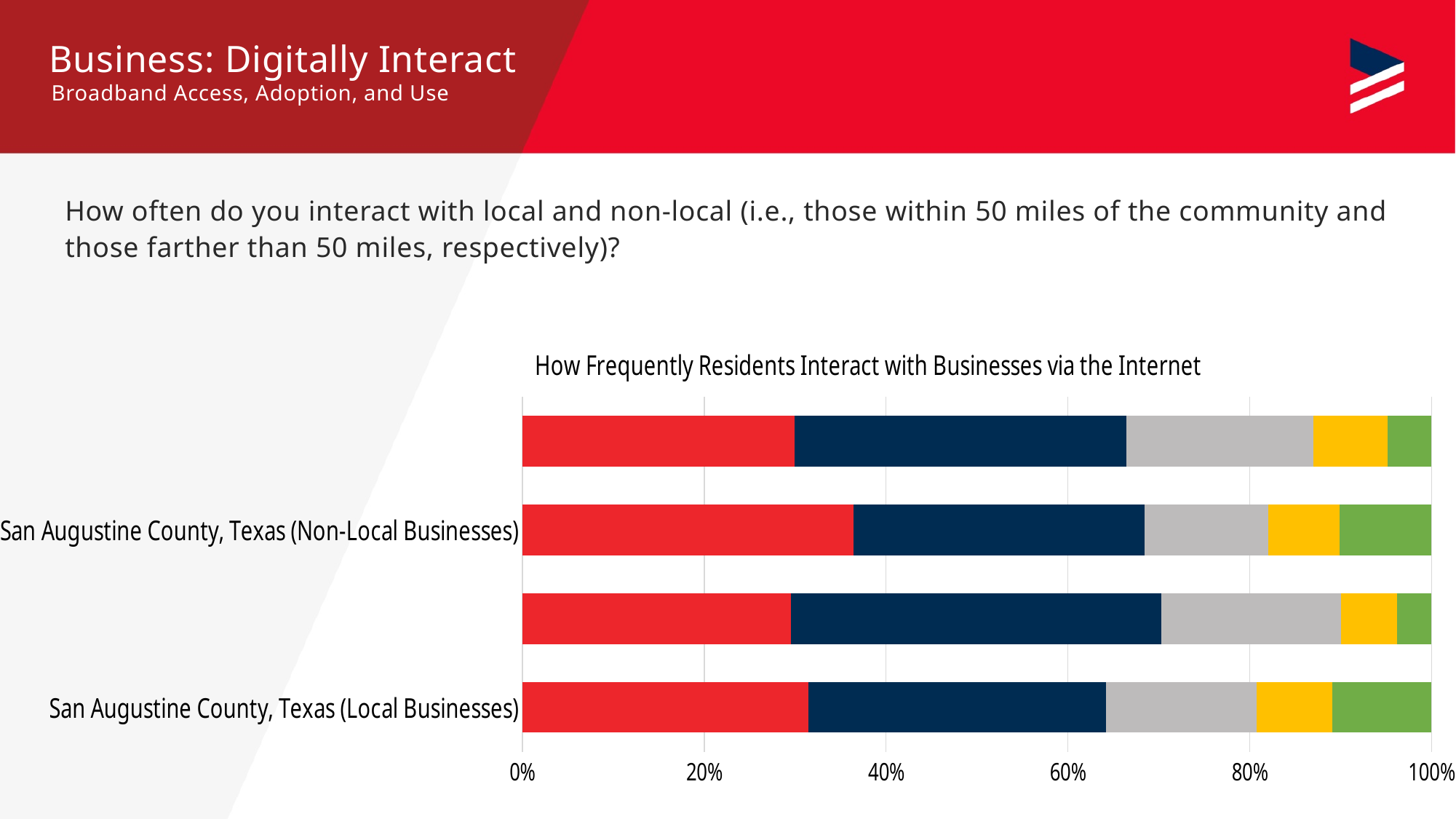
Which has the larger red (first) segment: the bar for San Augustine County, Texas (Non-Local Businesses) or the bar for San Augustine County, Texas (Local Businesses)? San Augustine County, Texas (Non-Local Businesses) How many coloured segments make up each bar in the chart? 5 How many bars are plotted in the chart? 4 Is the red (first) segment of the bar for San Augustine County, Texas (Local Businesses) greater or less than 40%? less Do the combined red and dark blue segments of the bar for San Augustine County, Texas (Local Businesses) reach greater or less than 60%? greater What is the highest value shown on the horizontal axis of the chart? 100% Is the red (first) segment of the bar for San Augustine County, Texas (Local Businesses) greater or less than 20%? greater What is the title of the chart? How Frequently Residents Interact with Businesses via the Internet What kind of chart is shown on the slide? Stacked bar chart